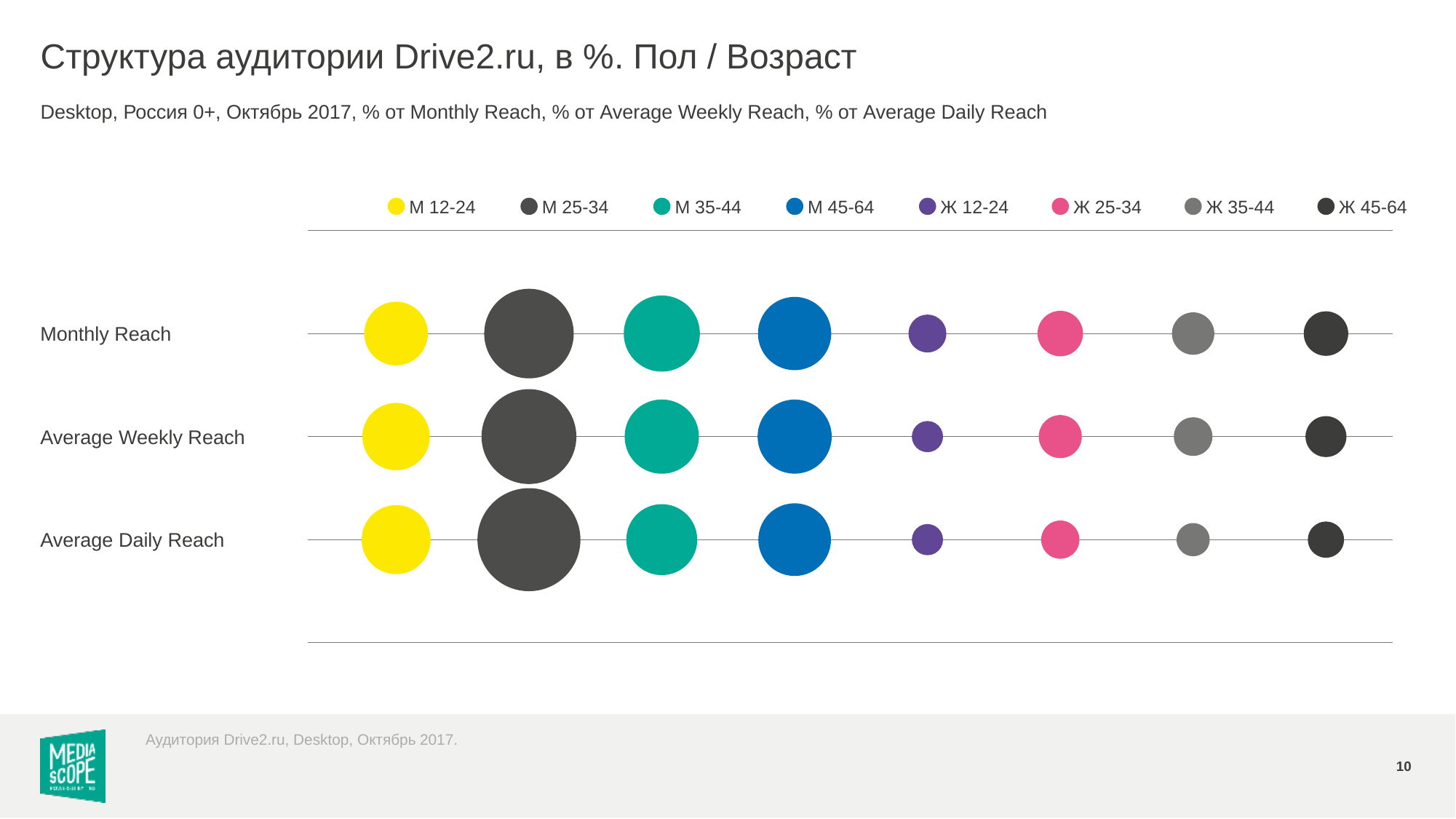
How many reach categories (rows) are plotted on the chart? 3 In the Average Daily Reach row, which bubble is larger: М 12-24 or Ж 35-44? М 12-24 What is the title of the slide? Структура аудитории Drive2.ru, в %. Пол / Возраст Which gender/age group has the smallest bubble in the Monthly Reach row? Ж 12-24 In the Average Weekly Reach row, which bubble is larger: М 35-44 or Ж 45-64? М 35-44 Which legend entry is shown in yellow? М 12-24 How many series does the legend list? 8 Which gender/age group has the largest bubble in the Monthly Reach row? М 25-34 Which gender/age group has the smallest bubble in the Average Weekly Reach row? Ж 12-24 Which gender/age group has the largest bubble in the Average Daily Reach row? М 25-34 In the Monthly Reach row, which bubble is larger: М 45-64 or Ж 25-34? М 45-64 What kind of chart is shown on the slide? bubble chart